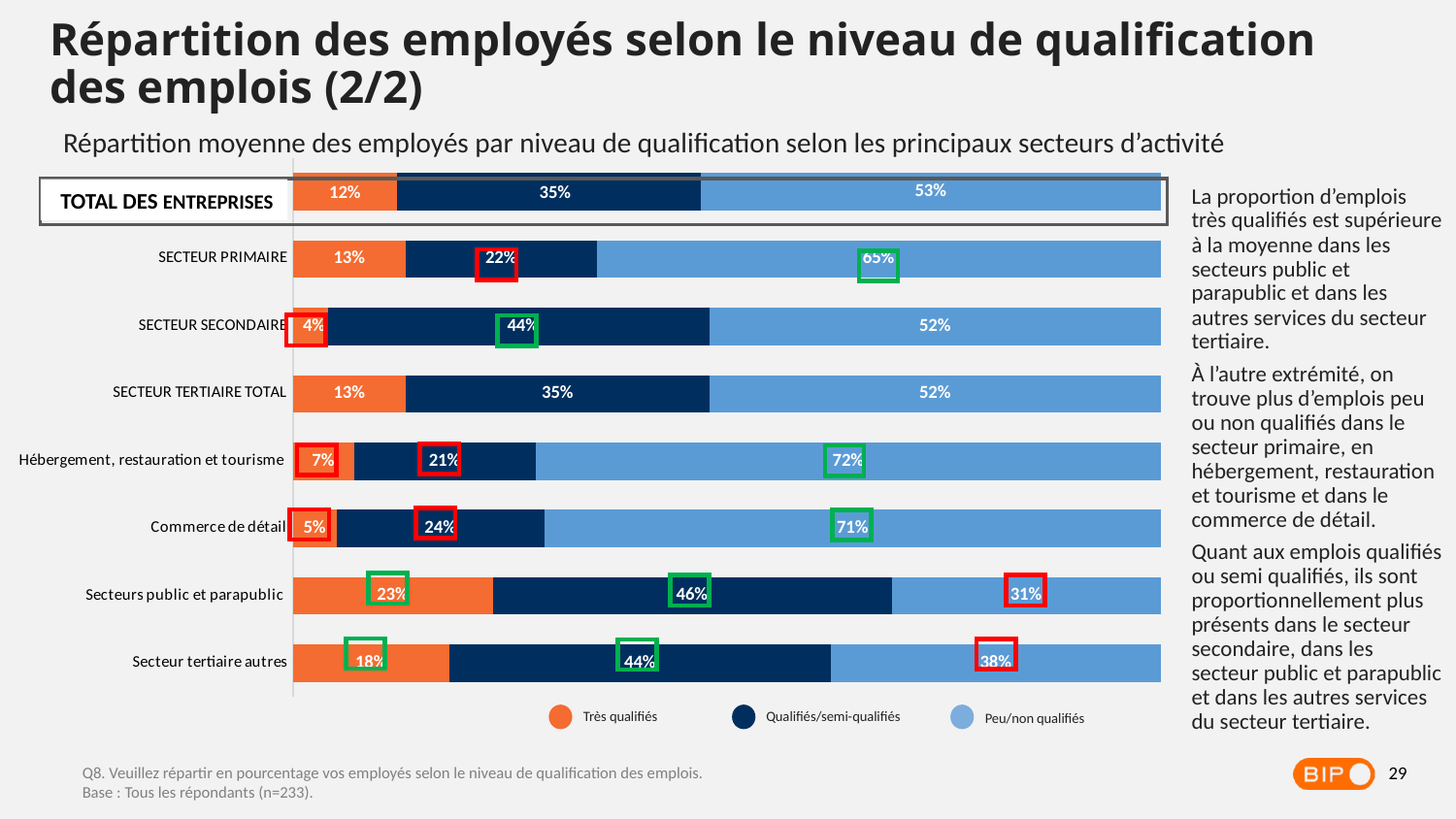
What type of chart is shown on the slide? Stacked bar chart What is the difference between the 'Peu/non qualifiés' share for SECTEUR PRIMAIRE and for TOTAL DES ENTREPRISES? 12 percentage points How many categories (sectors) are plotted in the chart? 8 Which is larger: the 'Qualifiés/semi-qualifiés' share for SECTEUR SECONDAIRE or for Commerce de détail? SECTEUR SECONDAIRE Which sector has the lowest 'Peu/non qualifiés' share? Secteurs public et parapublic What is the value of 'Qualifiés/semi-qualifiés' for Secteurs public et parapublic? 46% How many series does the legend list? 3 Which legend entry is shown in orange? Très qualifiés Which sector has the highest 'Très qualifiés' share? Secteurs public et parapublic What is the value of 'Très qualifiés' for TOTAL DES ENTREPRISES? 12% Which sector has the lowest 'Très qualifiés' share? SECTEUR SECONDAIRE What is the value of 'Peu/non qualifiés' for Hébergement, restauration et tourisme? 72%